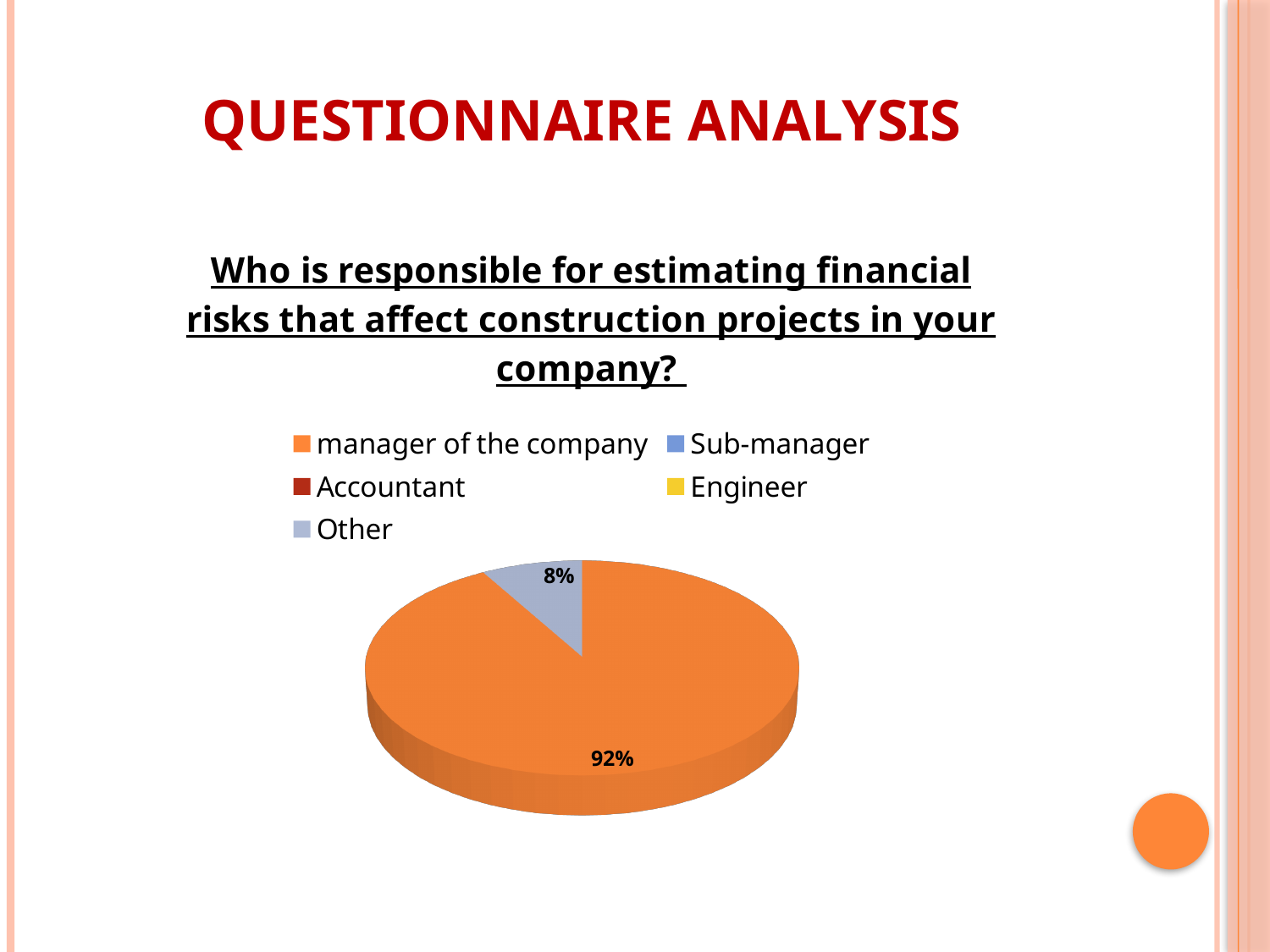
What question does the chart title ask? Who is responsible for estimating financial risks that affect construction projects in your company? How many categories does the legend list? 5 What share of the pie does "Other" hold? 8% What kind of chart is shown on the slide? pie chart What share of the pie does "manager of the company" hold? 92% What colour is the "manager of the company" slice? orange How many slices with data labels are visible in the pie? 2 Which is larger, the slice for "manager of the company" or the slice for "Other"? manager of the company Which category has the largest slice of the pie? manager of the company What is the difference in percentage points between the "manager of the company" slice and the "Other" slice? 84 percentage points Which of the two labelled slices is smaller? Other